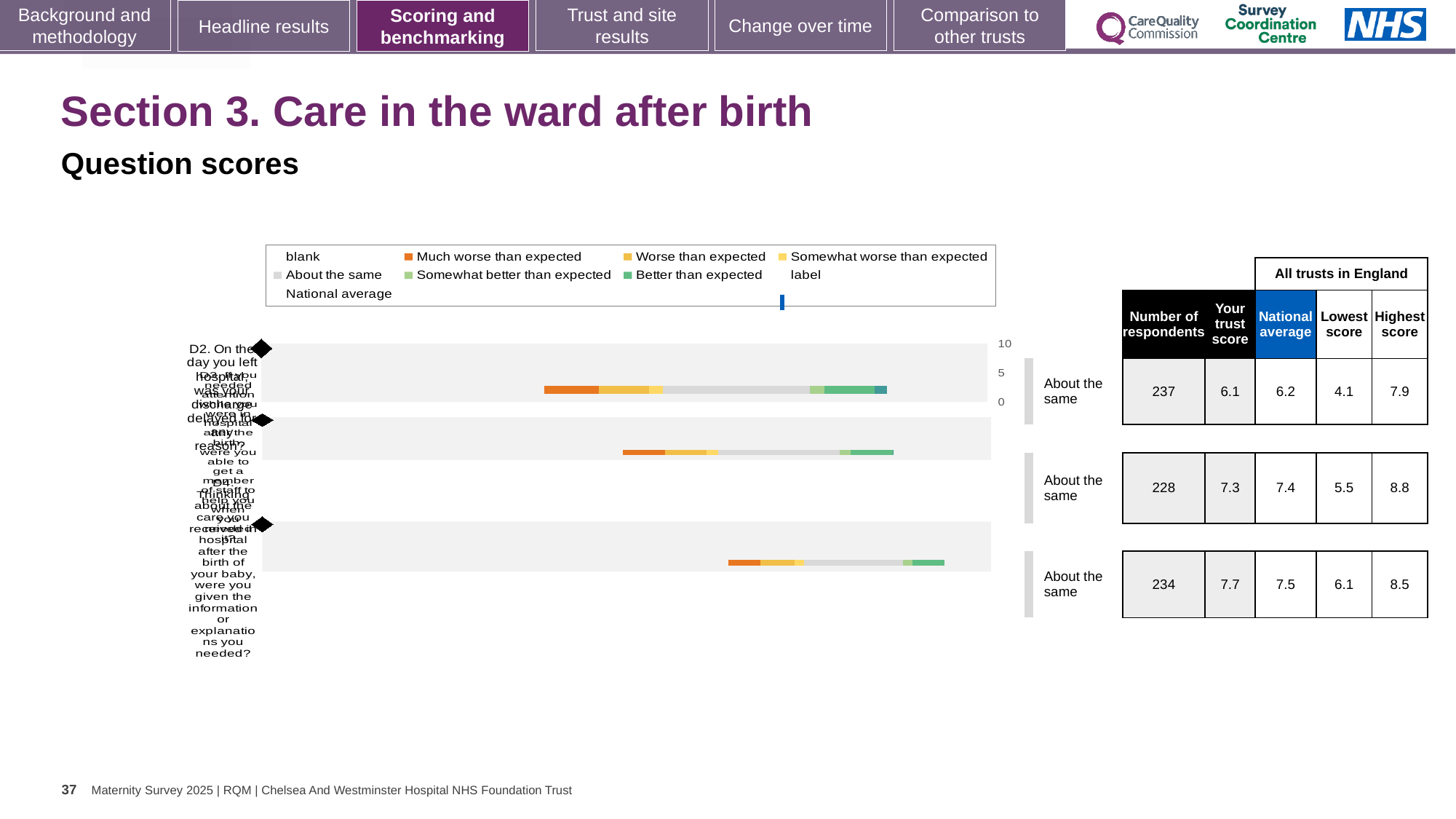
In the table beside the chart, what is the number of respondents for the first (top) question row? 237 Which question row has the highest trust score in the table beside the chart? the third (bottom) row Which question row has the lowest number of respondents in the table beside the chart? the second (middle) row In the table beside the chart, what is the lowest score for the first (top) question row? 4.1 In the table beside the chart, what is the highest score for the second (middle) question row? 8.8 How many question rows (bars) are plotted in the chart? 3 What kind of chart is shown on the slide? bar chart In the table beside the chart, what is the trust score for the second (middle) question row? 7.3 What is the difference between the national average and the trust score for the first (top) question row? 0.1 For the third (bottom) question row, is the trust score or the national average larger? trust score What comparison label is shown next to each of the three bars in the chart? About the same In the table beside the chart, what is the national average for the third (bottom) question row? 7.5